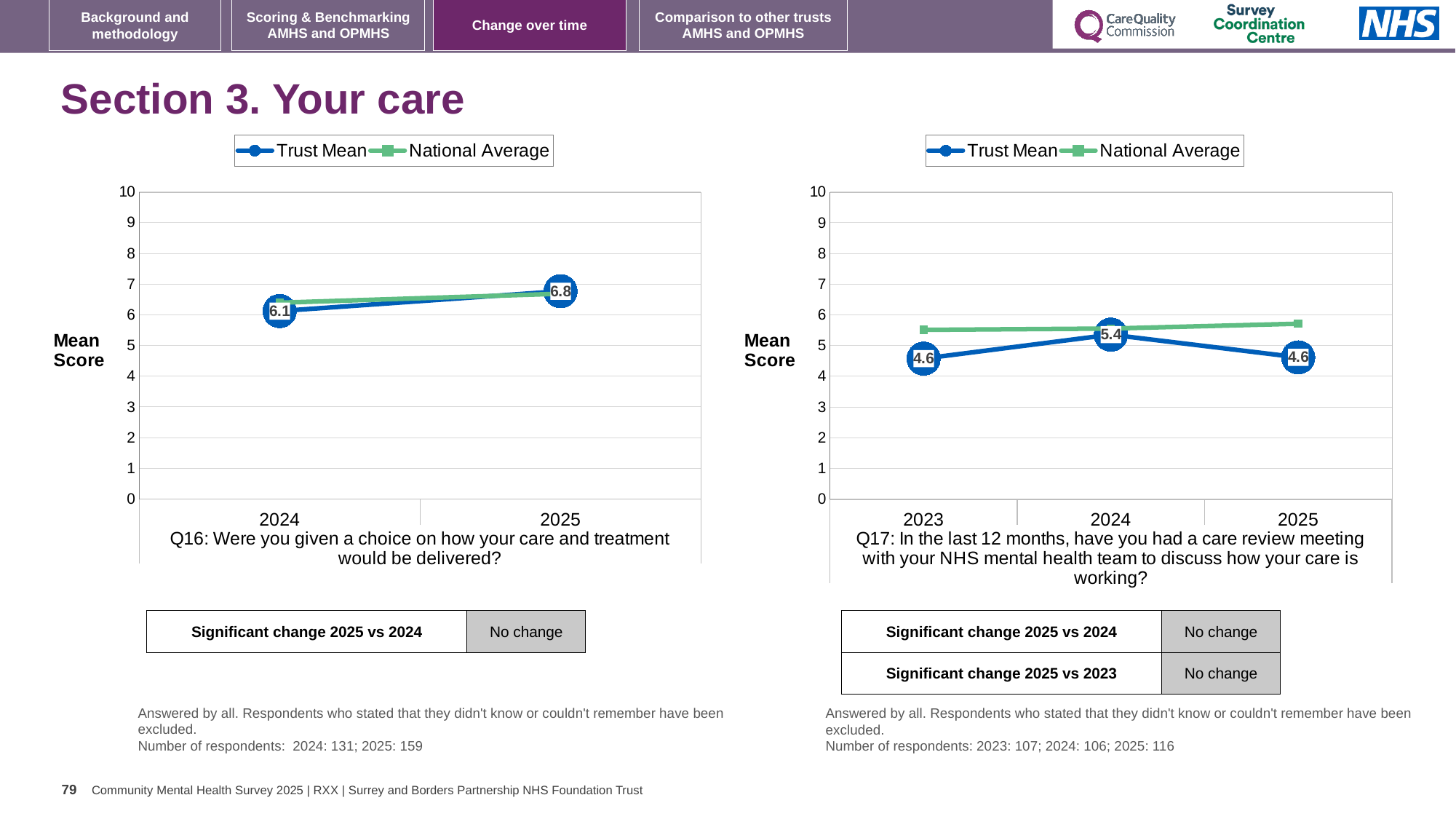
In the Q17 chart on the right, what is the Trust Mean for 2024? 5.4 How many series does the legend of the Q16 chart on the left list? 2 How many years are plotted on the x axis of the Q17 chart on the right? 3 In the Q16 chart on the left, is the Trust Mean higher in 2024 or 2025? 2025 In the Q16 chart on the left, what is the Trust Mean for 2024? 6.1 In the Q17 chart on the right, what is the Trust Mean for 2023? 4.6 What type of chart is used for Q16 on the left? Line chart In the Q16 chart on the left, by how much did the Trust Mean change from 2024 to 2025? 0.7 In the Q16 chart on the left, what is the Trust Mean for 2025? 6.8 In the Q17 chart on the right, what is the difference between the Trust Mean for 2024 and the Trust Mean for 2025? 0.8 In the Q17 chart on the right, is the National Average for 2025 greater or less than 5? greater In the Q17 chart on the right, which year has the highest Trust Mean? 2024